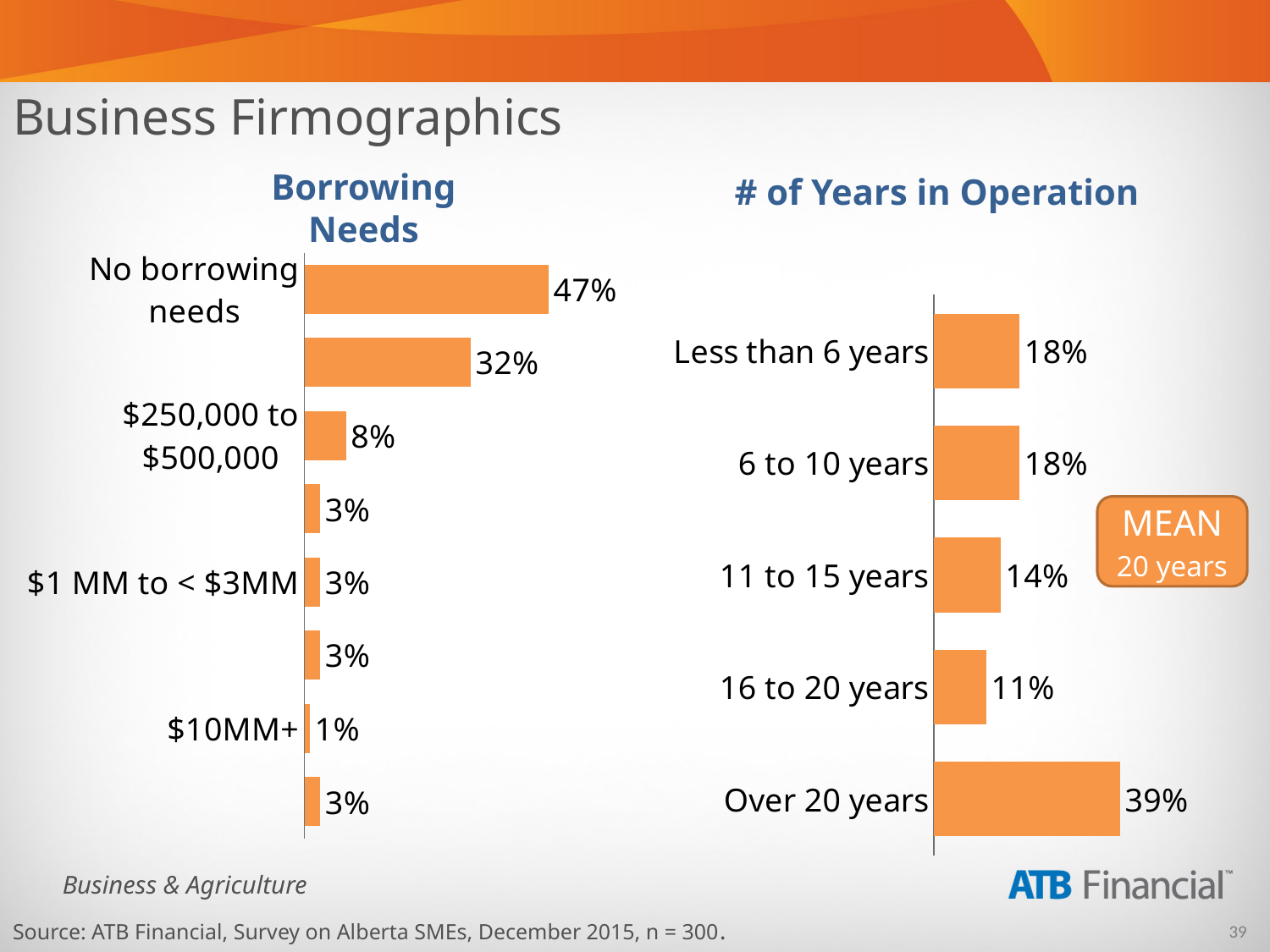
In the # of Years in Operation chart, which category has the lowest value? 16 to 20 years In the Borrowing Needs chart, what is the difference between No borrowing needs and $250,000 to $500,000? 39% In the # of Years in Operation chart, which is larger: 11 to 15 years or 16 to 20 years? 11 to 15 years In the Borrowing Needs chart, what percentage of businesses have no borrowing needs? 47% How many categories are shown in the # of Years in Operation chart? 5 In the Borrowing Needs chart, what is the value for $250,000 to $500,000? 8% In the # of Years in Operation chart, what is the value for Over 20 years? 39% In the Borrowing Needs chart, which category has the lowest value? $10MM+ In the Borrowing Needs chart, what is the value for $10MM+? 1% In the Borrowing Needs chart, which category has the highest value? No borrowing needs In the # of Years in Operation chart, what is the value for 16 to 20 years? 11% In the # of Years in Operation chart, what is the difference between Over 20 years and Less than 6 years? 21%